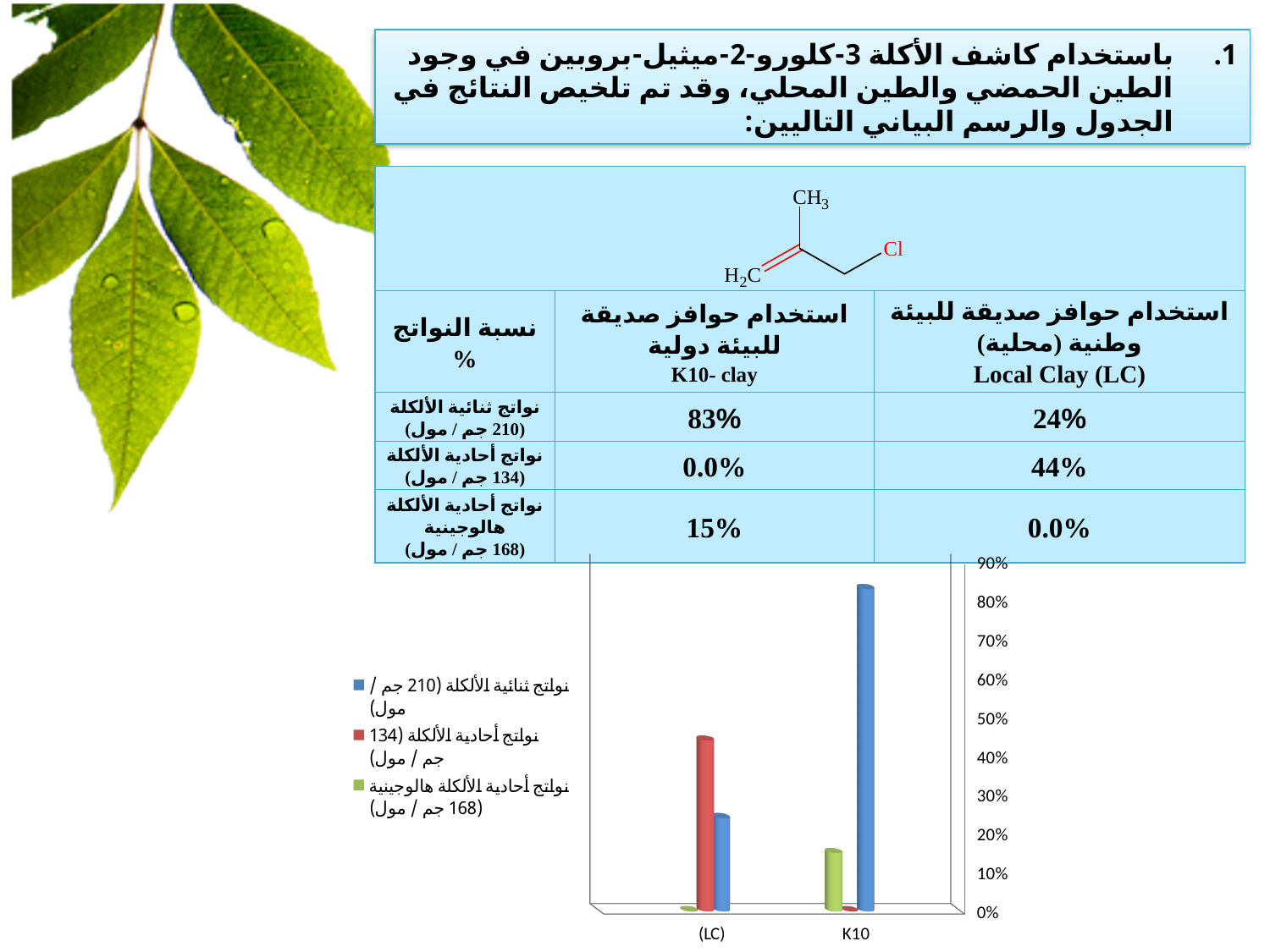
Which category has the tallest bar in the chart? K10 How many series does the legend of the bar chart list? 3 Is the blue bar (dialkylation products, 210 g/mol) for (LC) greater or less than 30%? less According to the table on the slide, what is the percentage of dialkylation products (210 g/mol) with K10-clay? 83% What kind of chart is shown at the bottom of the slide? bar chart Is the green bar (halogenated monoalkylation products, 168 g/mol) for K10 greater or less than 20%? less How many categories are shown on the x axis of the bar chart? 2 According to the table, what is the difference between the dialkylation product percentage for K10-clay and for Local Clay (LC)? 59% Is the blue bar (dialkylation products, 210 g/mol) for K10 greater or less than 80%? greater What is the highest value shown on the vertical axis of the bar chart? 90% For the (LC) category, which is larger: the red bar or the blue bar? the red bar